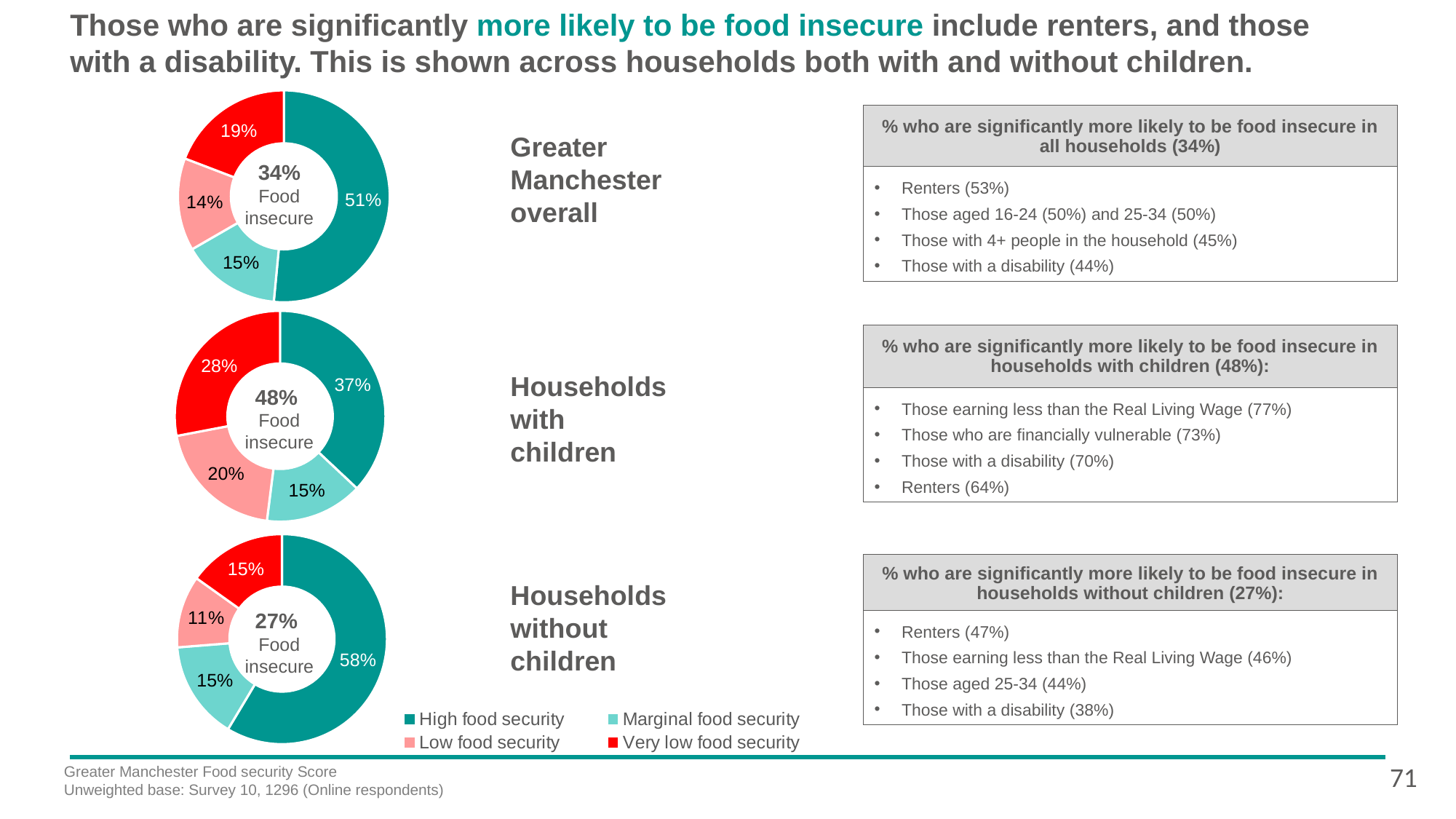
In the Households with children chart, what percentage is shown as food insecure in the centre of the donut? 48% In the Households without children chart, what percentage has low food security? 11% Which colour represents very low food security in the charts? Red In the Greater Manchester overall chart, which category has the smallest share? Low food security In the Households with children chart, what percentage has very low food security? 28% In the Households without children chart, which category has the largest share? High food security Which is larger in the Households with children chart: low food security or marginal food security? Low food security How many categories does the legend list for the food security charts? 4 In the Households with children chart, what is the difference between the very low food security share and the marginal food security share? 13% What kind of chart is used to show food security for Greater Manchester overall? Donut (pie) chart In the Households without children chart, what is the combined share of low and very low food security? 26% In the Greater Manchester overall chart, what percentage has high food security? 51%